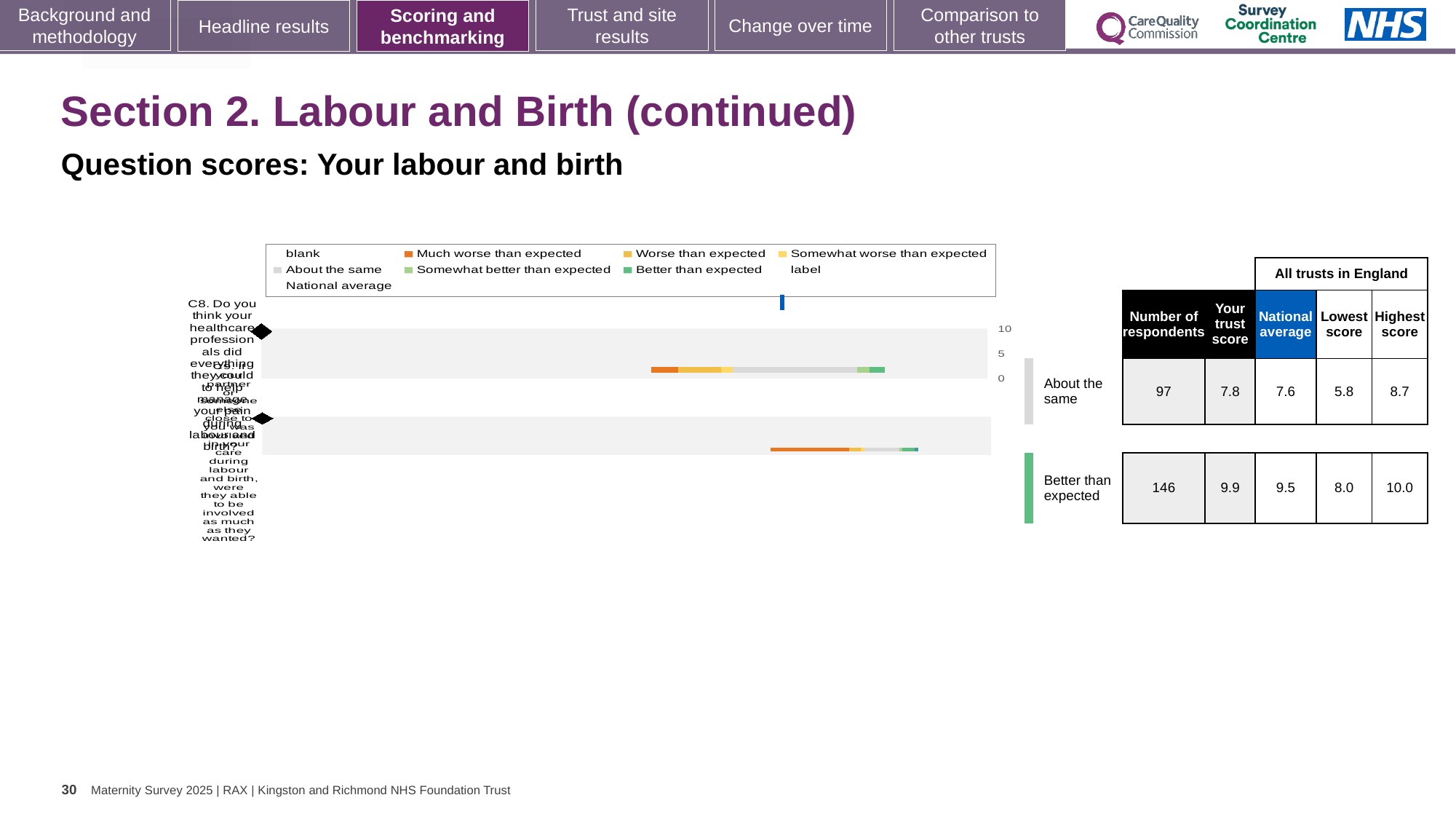
In the chart legend, what colour represents 'Better than expected'? green In the table beside the chart, how much higher is 'Your trust score' than the national average for the 'Better than expected' row? 0.4 In the table beside the chart, what is the highest score for the row rated 'Better than expected'? 10.0 In the table beside the chart, what is the national average for the row rated 'About the same'? 7.6 In the chart legend, what colour represents 'Much worse than expected'? orange In the table beside the chart, what is the lowest score for the row rated 'About the same'? 5.8 In the table beside the chart, what is 'Your trust score' for the row rated 'Better than expected'? 9.9 In the table beside the chart, how many respondents are listed for the row rated 'About the same'? 97 Which row in the table beside the chart has more respondents, 'About the same' or 'Better than expected'? Better than expected How many question bars are plotted in the chart? 2 What kind of chart is shown on the slide? bar chart In the table beside the chart, what is the difference in number of respondents between the 'Better than expected' row and the 'About the same' row? 49